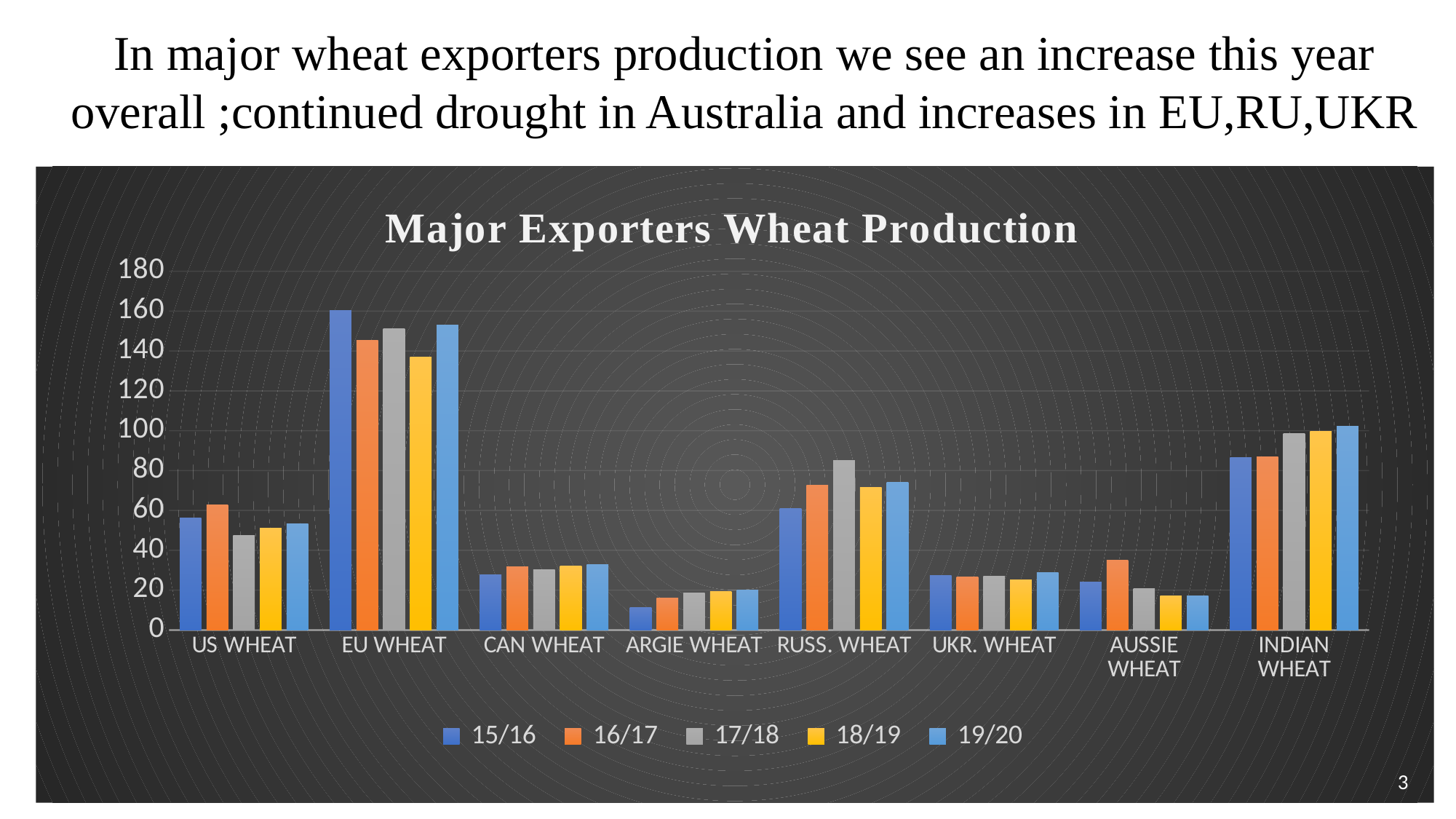
What is the title of the chart? Major Exporters Wheat Production Is the 15/16 value for EU WHEAT greater or less than 140? greater What type of chart is shown on the slide? bar chart For US WHEAT, which is larger: the 16/17 value or the 17/18 value? 16/17 How many wheat-producing categories are shown on the x axis? 8 Is the 15/16 value for ARGIE WHEAT greater or less than 20? less Which category has the highest 19/20 value? EU WHEAT Do the values for INDIAN WHEAT rise or fall from 15/16 to 19/20? rise For the 17/18 series, which is larger: RUSS. WHEAT or INDIAN WHEAT? INDIAN WHEAT Which category has the lowest 15/16 value? ARGIE WHEAT Is the 16/17 value for AUSSIE WHEAT greater or less than 20? greater How many series does the legend list in the Major Exporters Wheat Production chart? 5